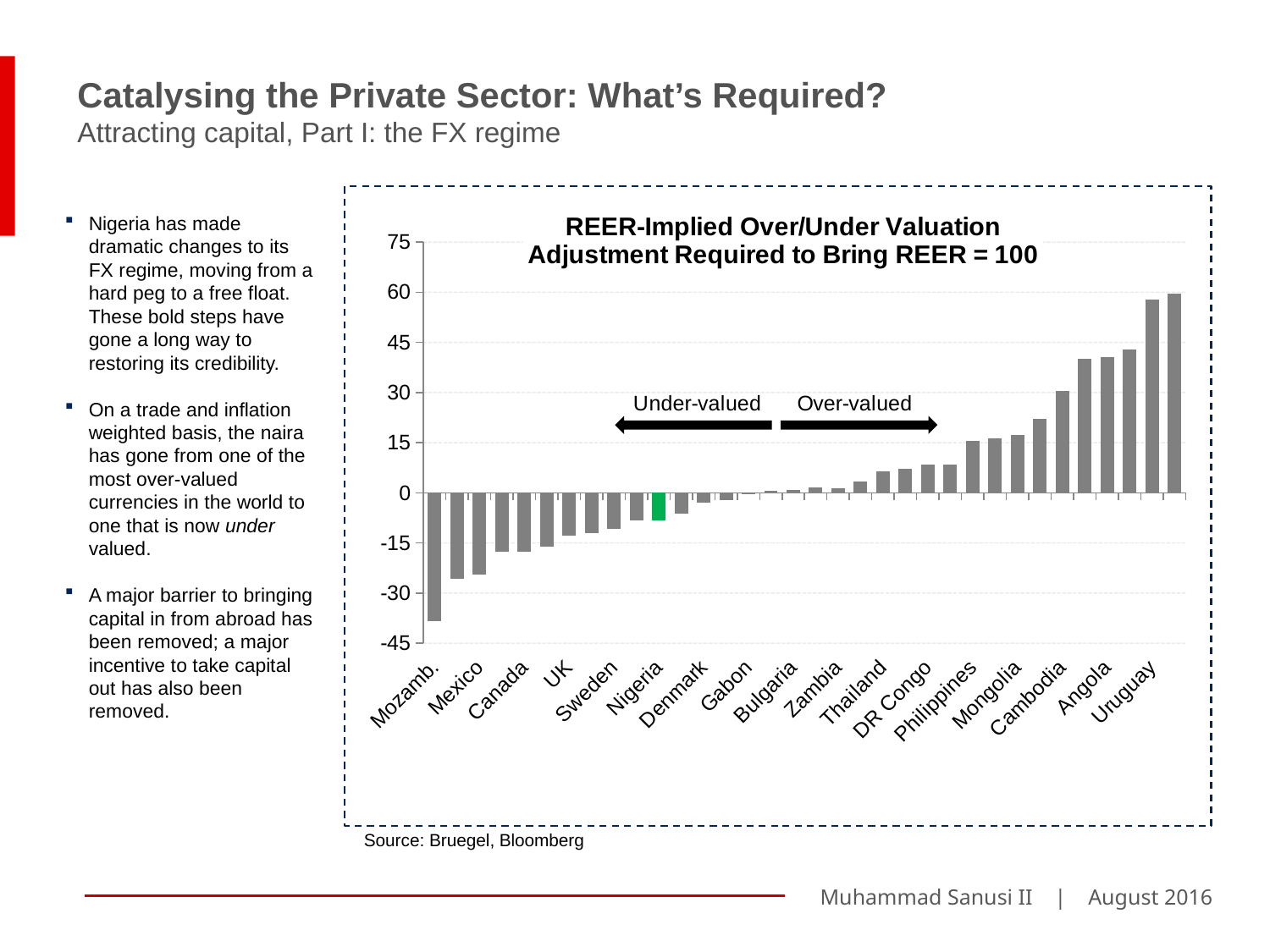
Is the value for Nigeria greater or less than 0? less What is the title of the chart? REER-Implied Over/Under Valuation Adjustment Required to Bring REER = 100 What colour is the bar for Nigeria? green Which labelled country has the highest value in the chart? Uruguay Do the values rise or fall moving from left to right along the x axis? rise Is the value for Mexico greater or less than -30? greater Which labelled country has the lowest value in the chart? Mozamb. Is the value for Mozamb. greater or less than -30? less What kind of chart is shown on the slide? bar chart Which is larger, the value for Uruguay or the value for Angola? Uruguay